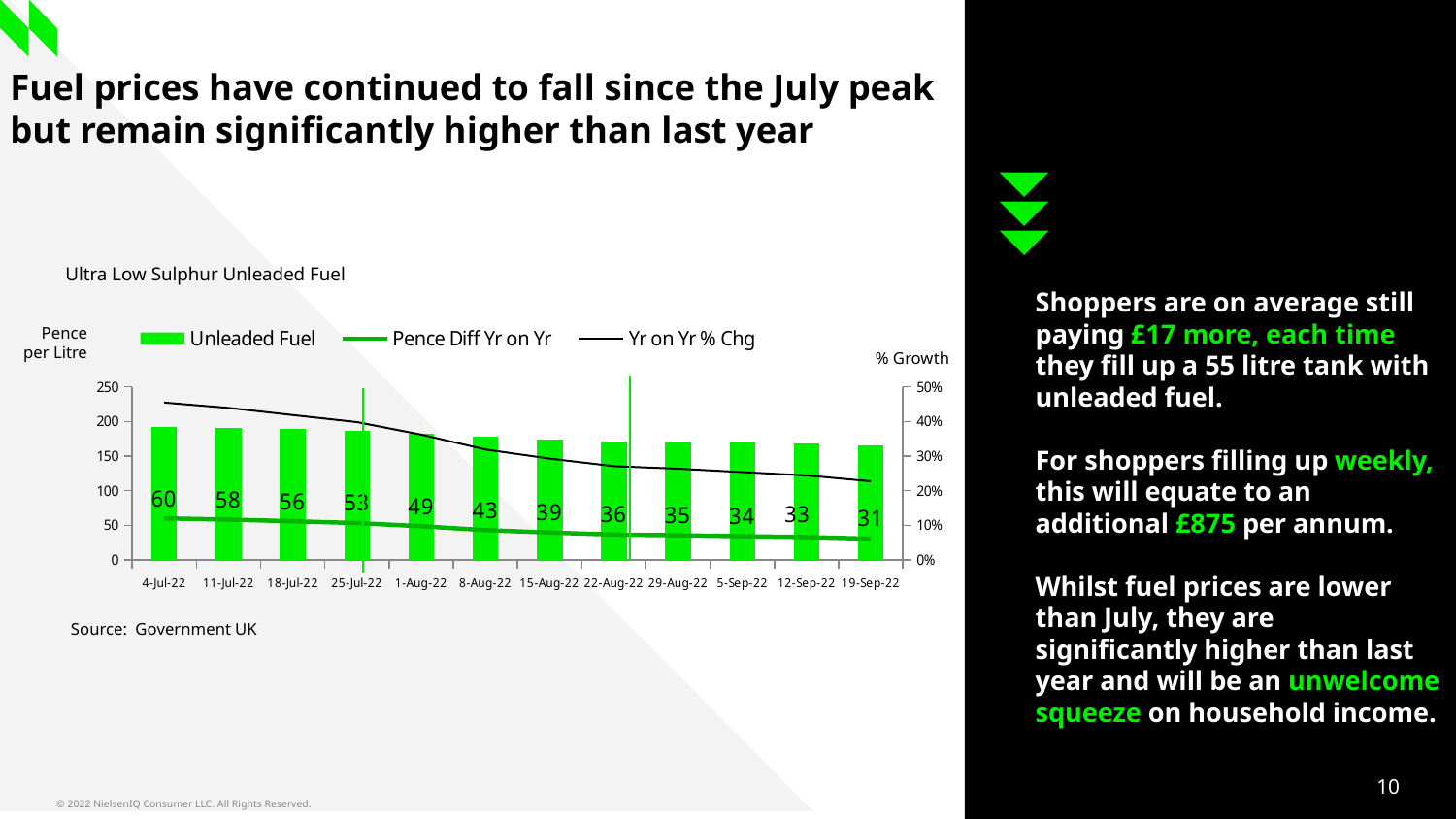
Do the Pence Diff Yr on Yr values rise or fall from 4-Jul-22 to 19-Sep-22? fall What is the Pence Diff Yr on Yr value for 8-Aug-22? 43 Which date has the highest Pence Diff Yr on Yr value? 4-Jul-22 What is the Pence Diff Yr on Yr value for 4-Jul-22? 60 Is the Unleaded Fuel bar for 4-Jul-22 greater or less than 150 pence per litre? greater What is the difference between the Pence Diff Yr on Yr values for 4-Jul-22 and 19-Sep-22? 29 Which date has the lowest Pence Diff Yr on Yr value? 19-Sep-22 How many dates are shown on the x axis of the chart? 12 Is the Yr on Yr % Chg line for 19-Sep-22 greater or less than 30%? less Which is larger, the Pence Diff Yr on Yr value for 25-Jul-22 or for 15-Aug-22? 25-Jul-22 What is the Pence Diff Yr on Yr value for 19-Sep-22? 31 How many series does the chart legend list? 3